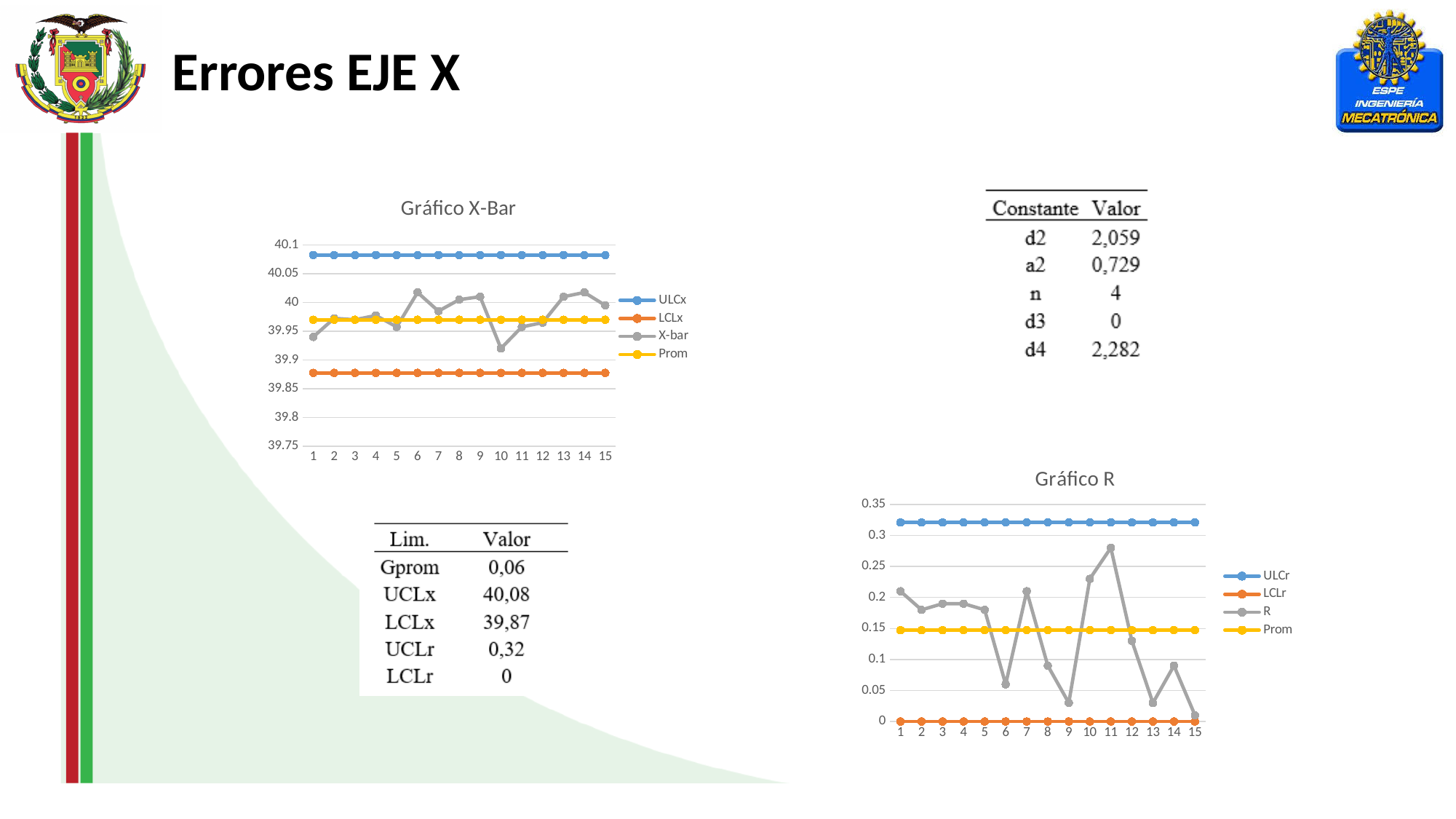
What kind of chart is the 'Gráfico X-Bar' chart? line chart In the 'Gráfico R' chart, is the value of the R series at point 11 greater or less than 0.25? greater In the 'Gráfico R' chart, which is larger: the R series value at point 7 or at point 8? point 7 How many series does the legend of the 'Gráfico X-Bar' chart list? 4 In the 'Gráfico X-Bar' chart, at which x-axis point does the X-bar series reach its lowest value? 10 What are the legend entries of the 'Gráfico R' chart? ULCr, LCLr, R, Prom In the 'Gráfico R' chart, at which x-axis point does the R series reach its highest value? 11 In the 'Gráfico R' chart, is the value of the R series at point 6 greater or less than 0.1? less What kind of chart is the 'Gráfico R' chart? line chart How many points are plotted along the x axis of the 'Gráfico R' chart? 15 In the 'Gráfico X-Bar' chart, is the ULCx line greater or less than 40.05? greater